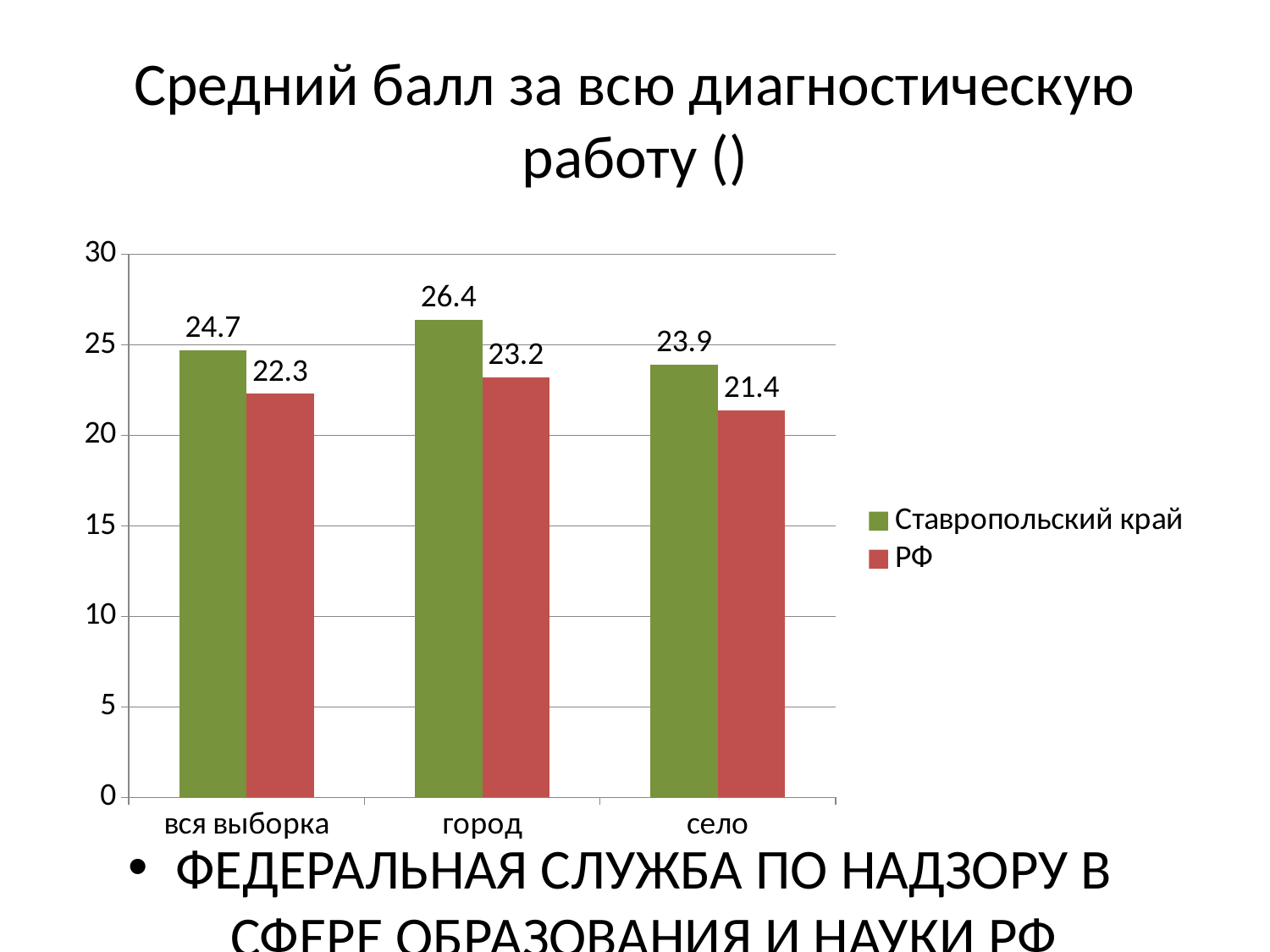
How many categories are shown on the x axis? 3 Which is larger in the город category: Ставропольский край or РФ? Ставропольский край What is the value for Ставропольский край in the город category? 26.4 What is the difference between Ставропольский край and РФ in the село category? 2.5 Which category has the lowest value for РФ? село Which series is shown in green? Ставропольский край How many series does the legend list? 2 Which category has the highest value for Ставропольский край? город What is the value for РФ in the вся выборка category? 22.3 What kind of chart is shown on the slide? bar chart What is the difference between Ставропольский край and РФ in the вся выборка category? 2.4 What is the value for РФ in the село category? 21.4